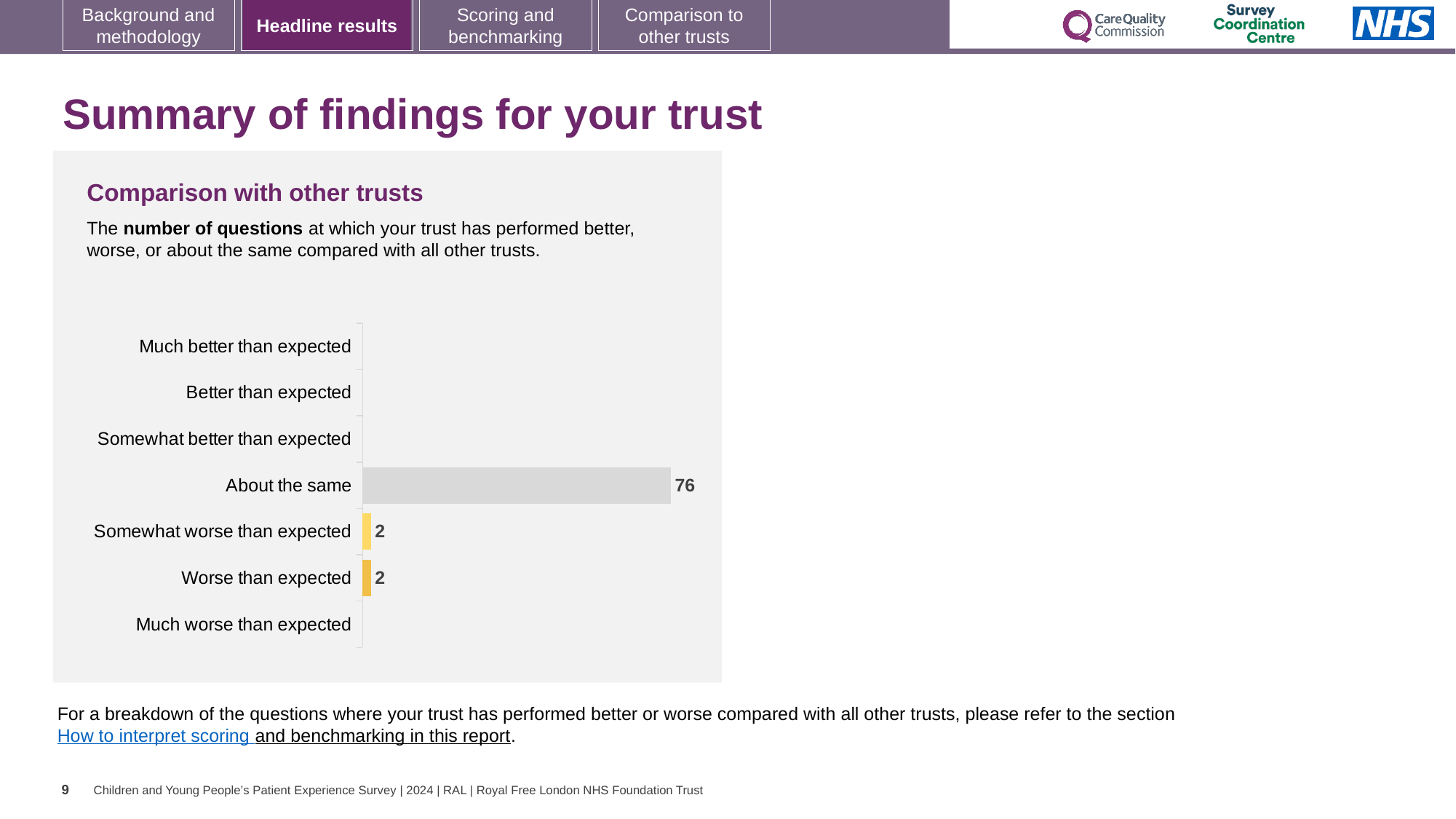
What colour is the bar for 'About the same'? Grey What is the title of the chart panel? Comparison with other trusts What is the combined number of questions in the 'Somewhat worse than expected' and 'Worse than expected' categories? 4 What is the difference between the 'About the same' value and the 'Worse than expected' value? 74 How many questions are in the 'About the same' category? 76 Which is larger: the value for 'About the same' or the value for 'Somewhat worse than expected'? About the same What kind of chart is shown on the slide? Bar chart What is the value for 'Somewhat worse than expected'? 2 Which category has the highest number of questions? About the same What is the value for 'Worse than expected'? 2 How many categories are listed on the chart's vertical axis? 7